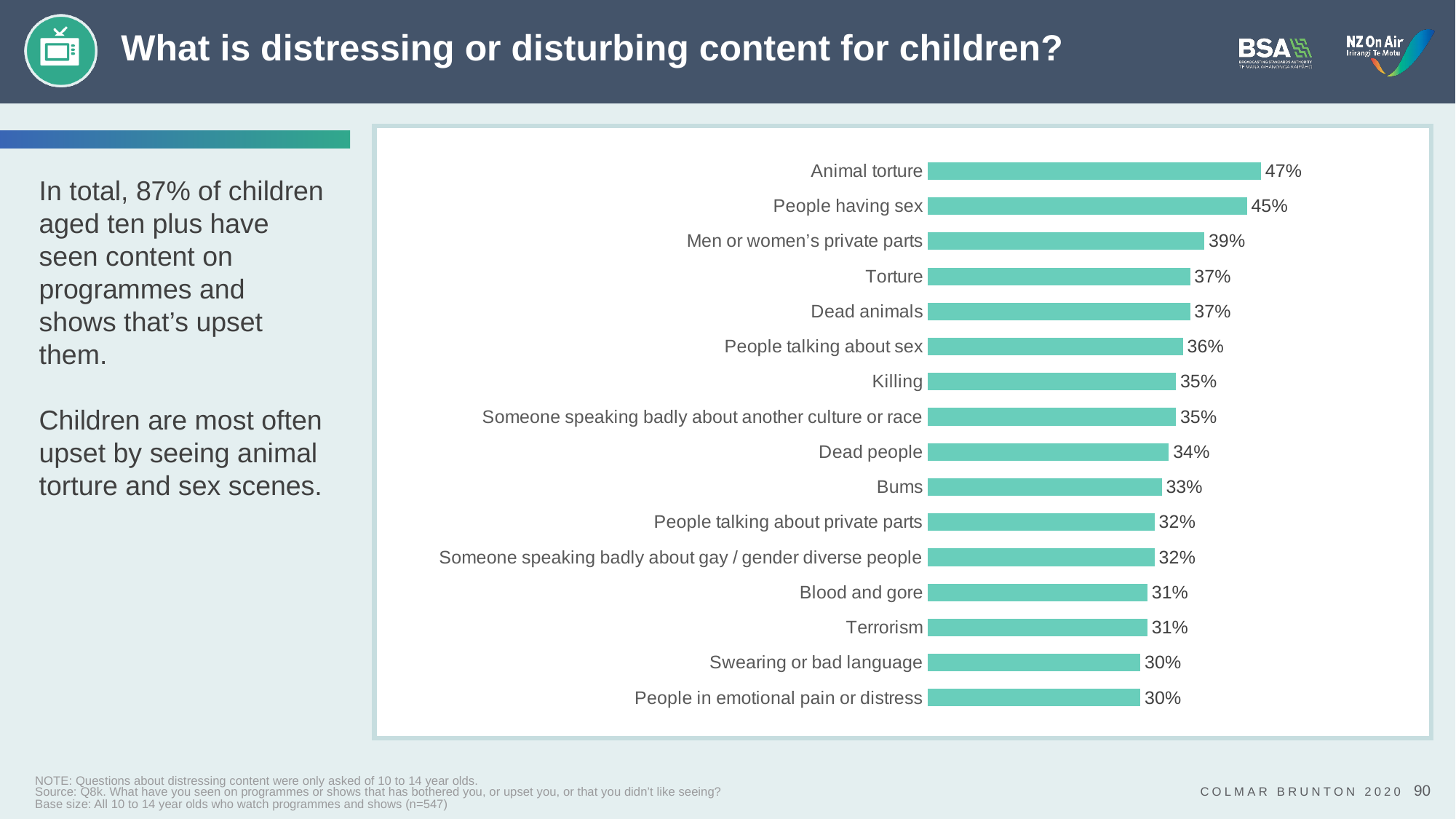
What type of chart is shown on the slide? Bar chart Which is larger, the value for 'People talking about sex' or the value for 'Swearing or bad language'? People talking about sex Which category has the highest percentage in the chart? Animal torture How many categories are shown in the chart? 16 What is the difference between the percentages for 'Animal torture' and 'People having sex'? 2% What is the difference between the values for 'Men or women's private parts' and 'Dead people'? 5% What colour are the bars in the chart? Teal/green What is the value for 'Bums'? 33% What is the value shown for 'Blood and gore'? 31% What percentage of children were upset by seeing animal torture? 47% Which has a higher value, 'Killing' or 'Terrorism'? Killing What percentage is shown for 'Someone speaking badly about another culture or race'? 35%